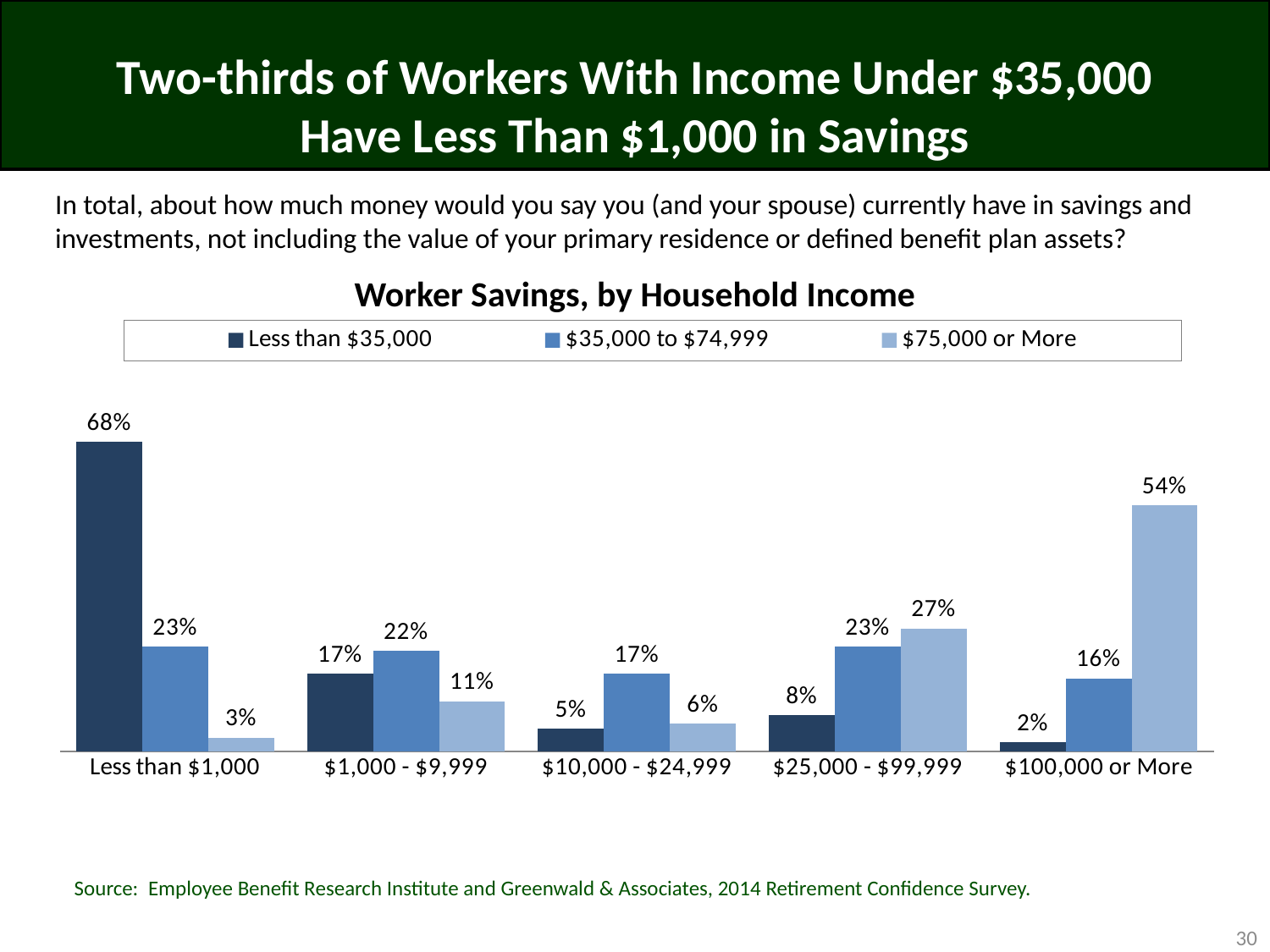
Which savings category has the lowest value for the $75,000 or More income group? Less than $1,000 Which savings category has the highest value for the Less than $35,000 income group? Less than $1,000 How many savings categories are shown on the x axis? 5 What is the title of the chart? Worker Savings, by Household Income What is the value for the $35,000 to $74,999 income group in the $10,000 - $24,999 savings category? 17% In the $25,000 - $99,999 savings category, which income group has the larger value: $35,000 to $74,999 or $75,000 or More? $75,000 or More What kind of chart is shown on the slide? Bar chart What percentage of workers with household income less than $35,000 have less than $1,000 in savings? 68% How many series does the legend list? 3 What is the difference between the Less than $35,000 and $75,000 or More values in the Less than $1,000 savings category? 65% What percentage of workers with household income of $75,000 or more have $100,000 or more in savings? 54%